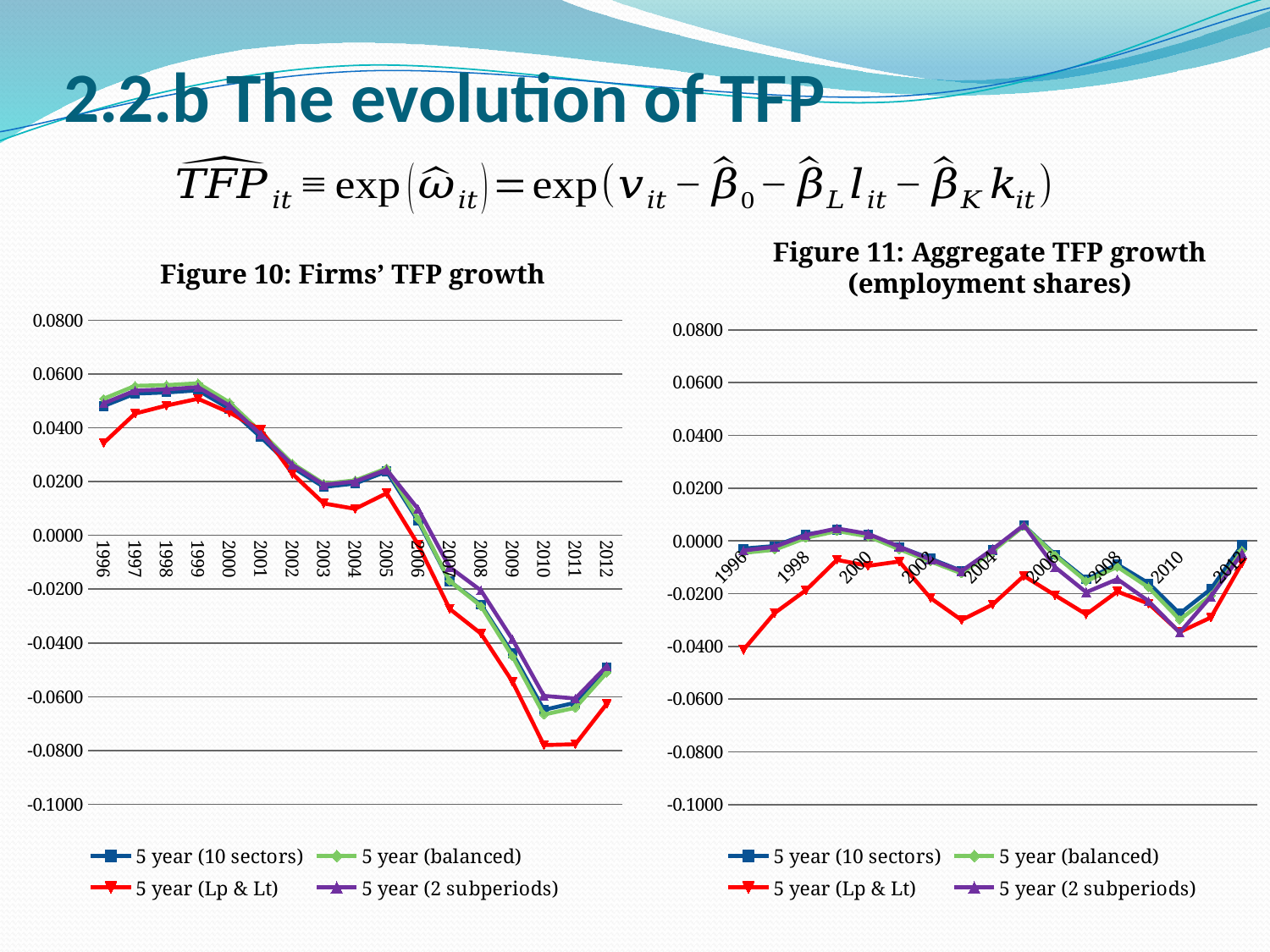
How many series does the legend of Figure 11: Aggregate TFP growth (employment shares) list? 4 In Figure 11: Aggregate TFP growth (employment shares), do the values for 5 year (10 sectors) rise or fall from 2010 to 2012? rise In Figure 10: Firms' TFP growth, what colour is the line for 5 year (Lp & Lt)? red What kind of chart is Figure 10: Firms' TFP growth? line chart In Figure 10: Firms' TFP growth, which is larger in 1996: the value for 5 year (10 sectors) or the value for 5 year (Lp & Lt)? 5 year (10 sectors) In Figure 11: Aggregate TFP growth (employment shares), is the value for 5 year (10 sectors) in 2006 greater or less than 0.0200? less In Figure 10: Firms' TFP growth, is the value for 5 year (Lp & Lt) in 1996 greater or less than 0.0200? greater In Figure 10: Firms' TFP growth, do the values for 5 year (balanced) rise or fall from 1999 to 2010? fall In Figure 11: Aggregate TFP growth (employment shares), is the value for 5 year (Lp & Lt) in 2010 greater or less than -0.0200? less How many years are shown on the x axis of Figure 10: Firms' TFP growth? 17 In Figure 11: Aggregate TFP growth (employment shares), which is larger in 1996: the value for 5 year (10 sectors) or the value for 5 year (Lp & Lt)? 5 year (10 sectors)